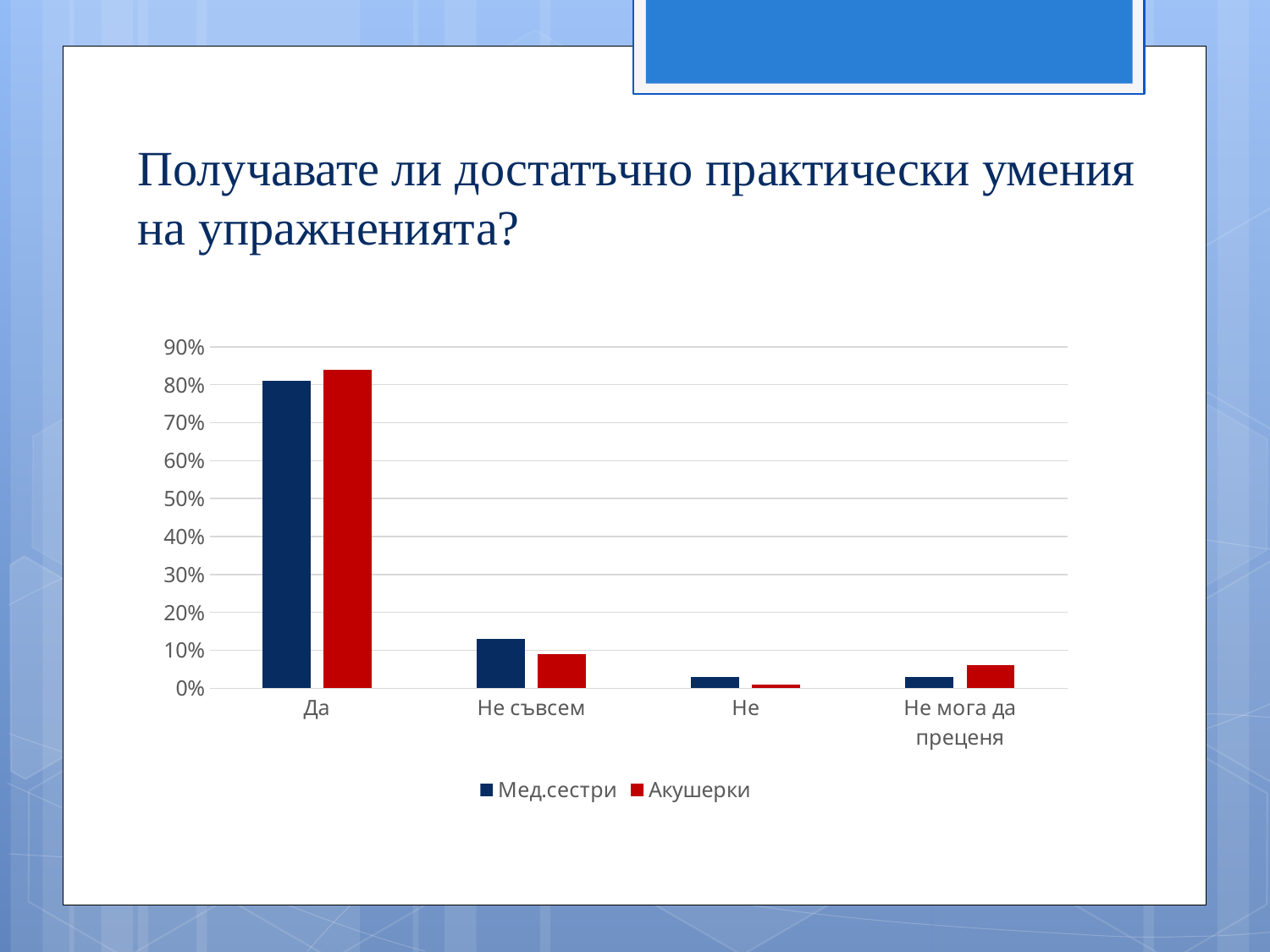
Which colour represents the Акушерки series in the chart? red How many series does the legend list? 2 Is the value for Акушерки in the Не съвсем category greater or less than 20%? less Which category has the lowest value for Акушерки? Не Which category has the highest value for Акушерки? Да Is the value for Мед.сестри in the Не съвсем category greater or less than 10%? greater How many answer categories are shown on the x axis? 4 Which category has the highest value for Мед.сестри? Да What kind of chart is shown on the slide? bar chart Is the value for Мед.сестри in the Да category greater or less than 70%? greater In the Да category, which series has the larger value, Мед.сестри or Акушерки? Акушерки In the Не съвсем category, which series has the larger value, Мед.сестри or Акушерки? Мед.сестри